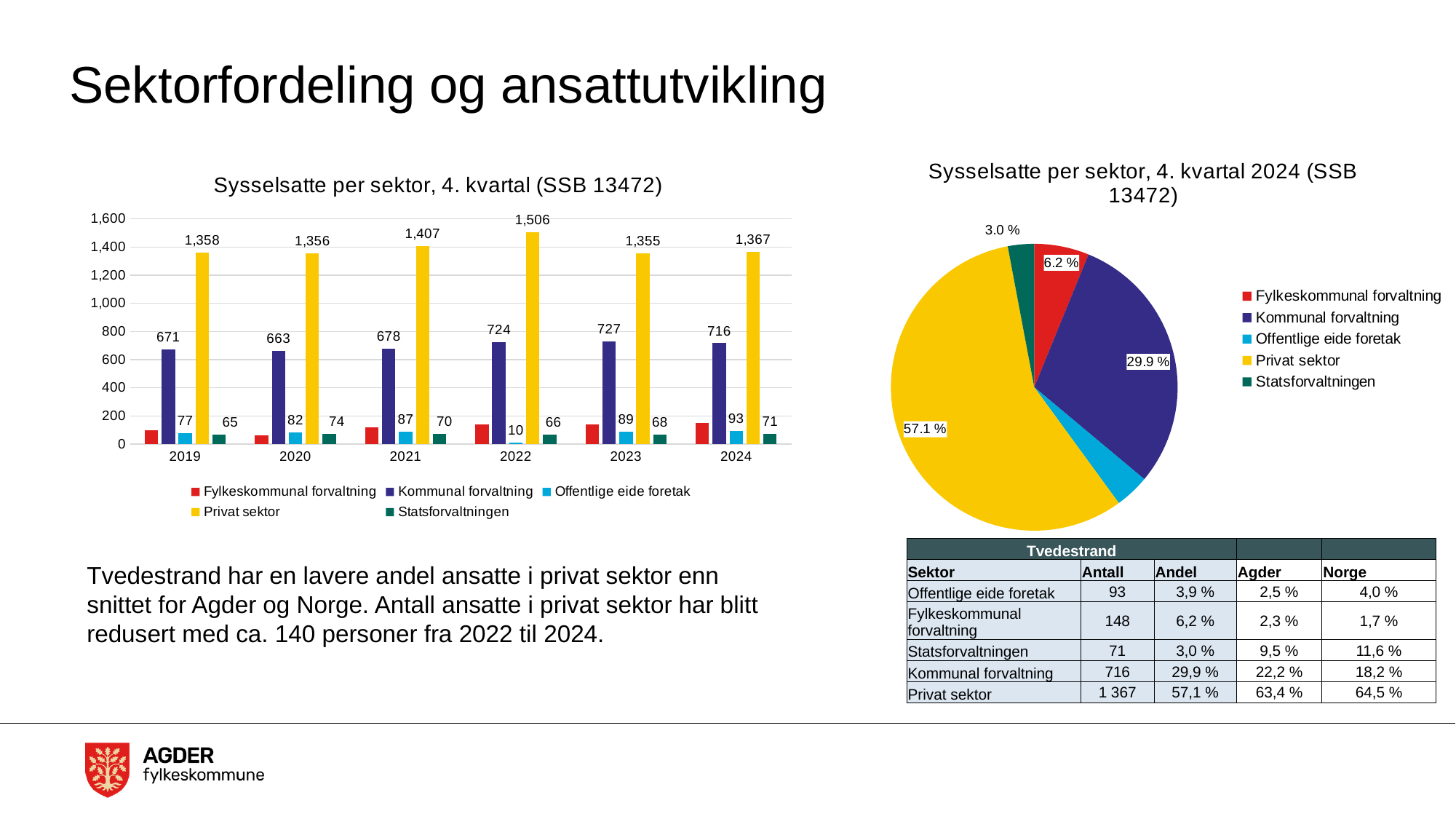
How many years are shown on the x axis of the left bar chart? 6 In the pie chart 'Sysselsatte per sektor, 4. kvartal 2024 (SSB 13472)', what share does Kommunal forvaltning have? 29.9 % In the left bar chart, is the value for Fylkeskommunal forvaltning in 2024 greater or less than 200? less In the left bar chart, what is the value for Privat sektor in 2022? 1,506 In the left bar chart, what is the value for Kommunal forvaltning in 2023? 727 How many series does the legend of the left bar chart list? 5 In the left bar chart, which year has the lowest value for Offentlige eide foretak? 2022 In the left bar chart, what is the difference between the Privat sektor values for 2022 and 2024? 139 What kind of chart is the left chart titled 'Sysselsatte per sektor, 4. kvartal (SSB 13472)'? Bar chart In the pie chart 'Sysselsatte per sektor, 4. kvartal 2024 (SSB 13472)', what share does Privat sektor have? 57.1 % In the left bar chart, which year has the larger value for Statsforvaltningen, 2019 or 2020? 2020 In the left bar chart, which year has the highest value for Privat sektor? 2022